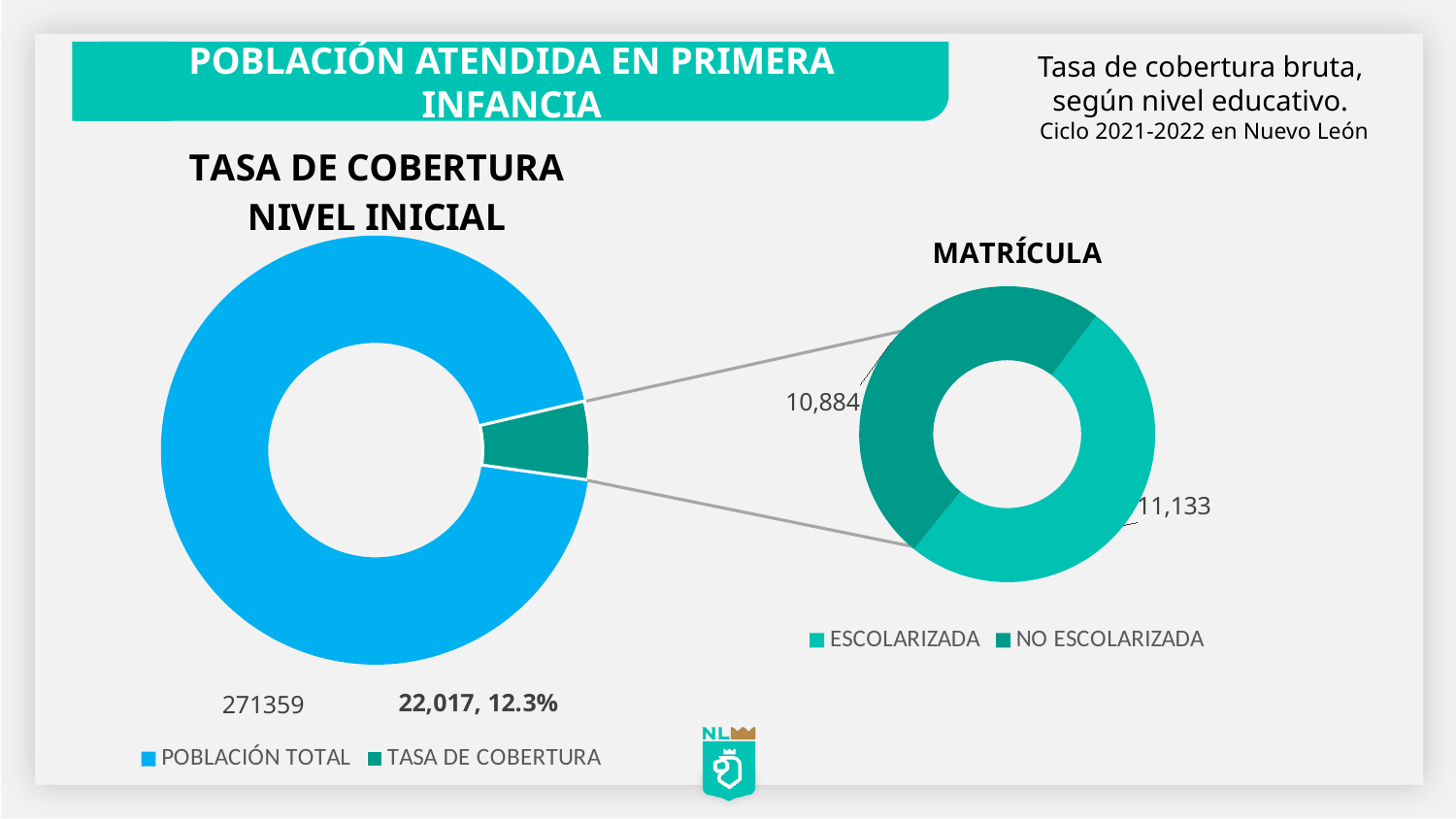
In the MATRÍCULA chart, what is the difference between ESCOLARIZADA and NO ESCOLARIZADA? 249 In the TASA DE COBERTURA NIVEL INICIAL chart, what percentage share is shown for TASA DE COBERTURA? 12.3% In the MATRÍCULA chart, what is the value for NO ESCOLARIZADA? 10,884 What kind of chart is the MATRÍCULA chart? Doughnut chart In the TASA DE COBERTURA NIVEL INICIAL chart, what value is labelled for TASA DE COBERTURA? 22,017, 12.3% How many entries does the legend of the MATRÍCULA chart list? 2 In the TASA DE COBERTURA NIVEL INICIAL chart, which category is the largest? POBLACIÓN TOTAL In the MATRÍCULA chart, which category is larger, ESCOLARIZADA or NO ESCOLARIZADA? ESCOLARIZADA In the TASA DE COBERTURA NIVEL INICIAL chart, what is the value for POBLACIÓN TOTAL? 271359 In the MATRÍCULA chart, what is the value for ESCOLARIZADA? 11,133 How many categories does the TASA DE COBERTURA NIVEL INICIAL chart show? 2 In the MATRÍCULA chart, what is the total of ESCOLARIZADA and NO ESCOLARIZADA? 22,017